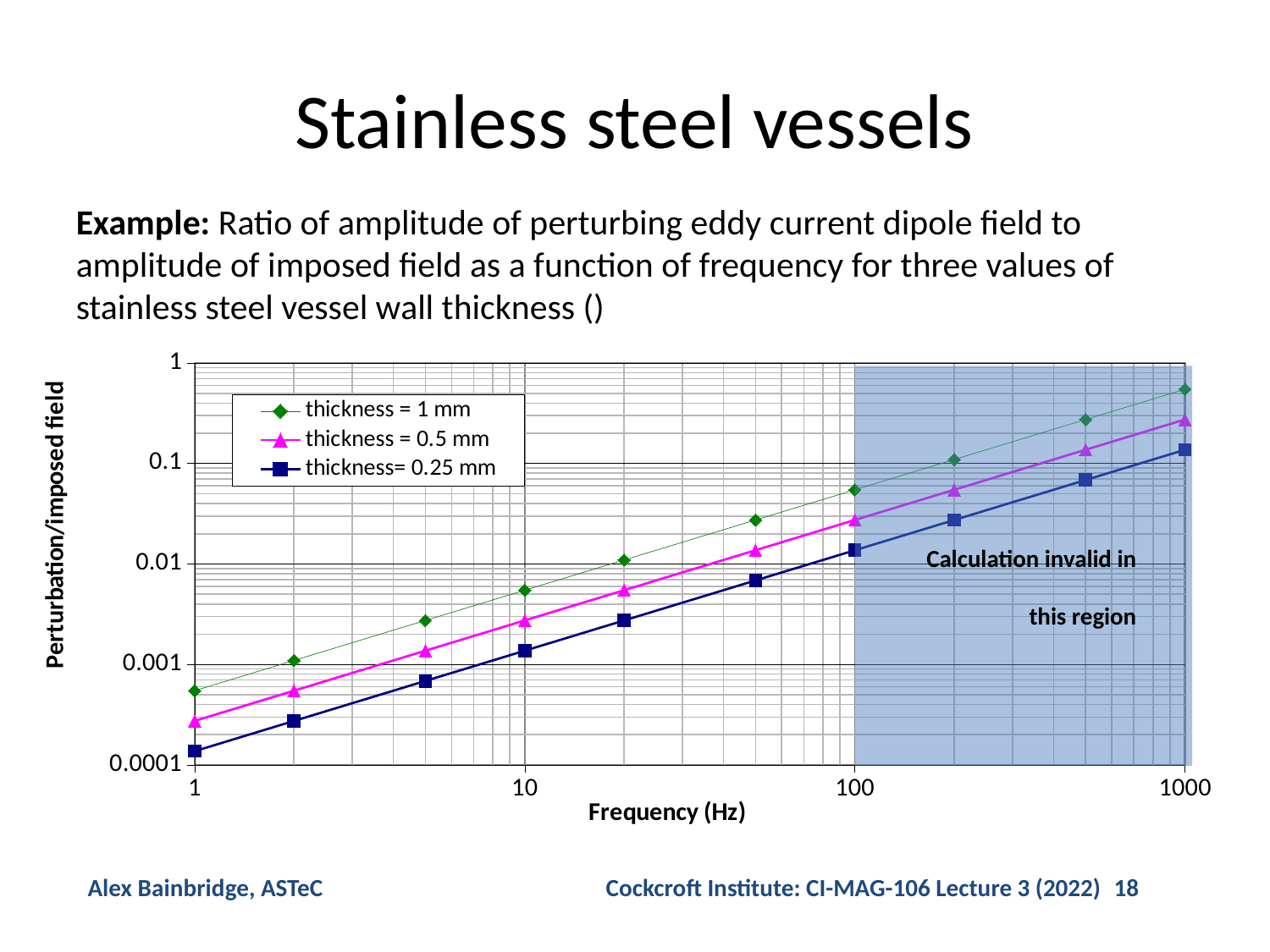
Is the value for thickness = 1 mm at 100 Hz greater or less than 0.1? less How many data points are plotted for the thickness = 0.5 mm series? 10 Is the value for thickness = 0.5 mm at 10 Hz greater or less than 0.01? less Is the value for thickness = 1 mm at 1000 Hz greater or less than 0.1? greater Which series has the lowest values across the frequency range? thickness= 0.25 mm Which series has the highest value at 1000 Hz? thickness = 1 mm Do the values for thickness = 1 mm rise or fall as frequency increases? rise At 100 Hz, which series has the larger value: thickness = 1 mm or thickness= 0.25 mm? thickness = 1 mm What is the label of the x axis? Frequency (Hz) How many series does the legend list? 3 What kind of chart is shown on the slide? line chart